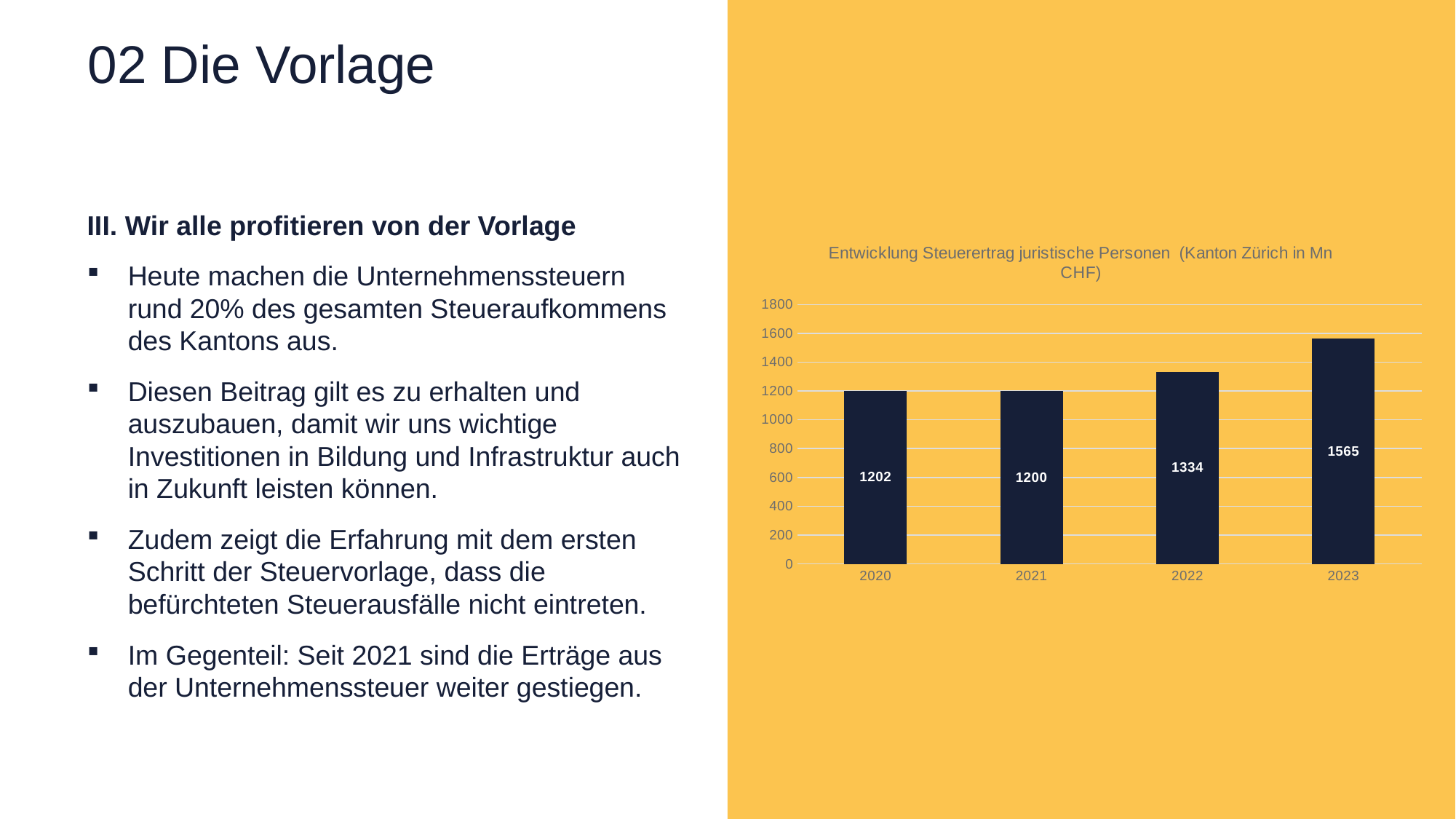
What is the value for 2023? 1565 What kind of chart is shown? bar chart What is the value for 2020? 1202 What is the difference between the values for 2023 and 2022? 231 What is the title of the chart? Entwicklung Steuerertrag juristische Personen (Kanton Zürich in Mn CHF) Which year has the lowest value? 2021 What is the value for 2022? 1334 Which year has the highest value? 2023 What is the difference between the values for 2020 and 2021? 2 Which is larger, the value for 2022 or the value for 2021? 2022 Is the value for 2023 greater or less than 1400? greater How many years are shown on the x axis? 4